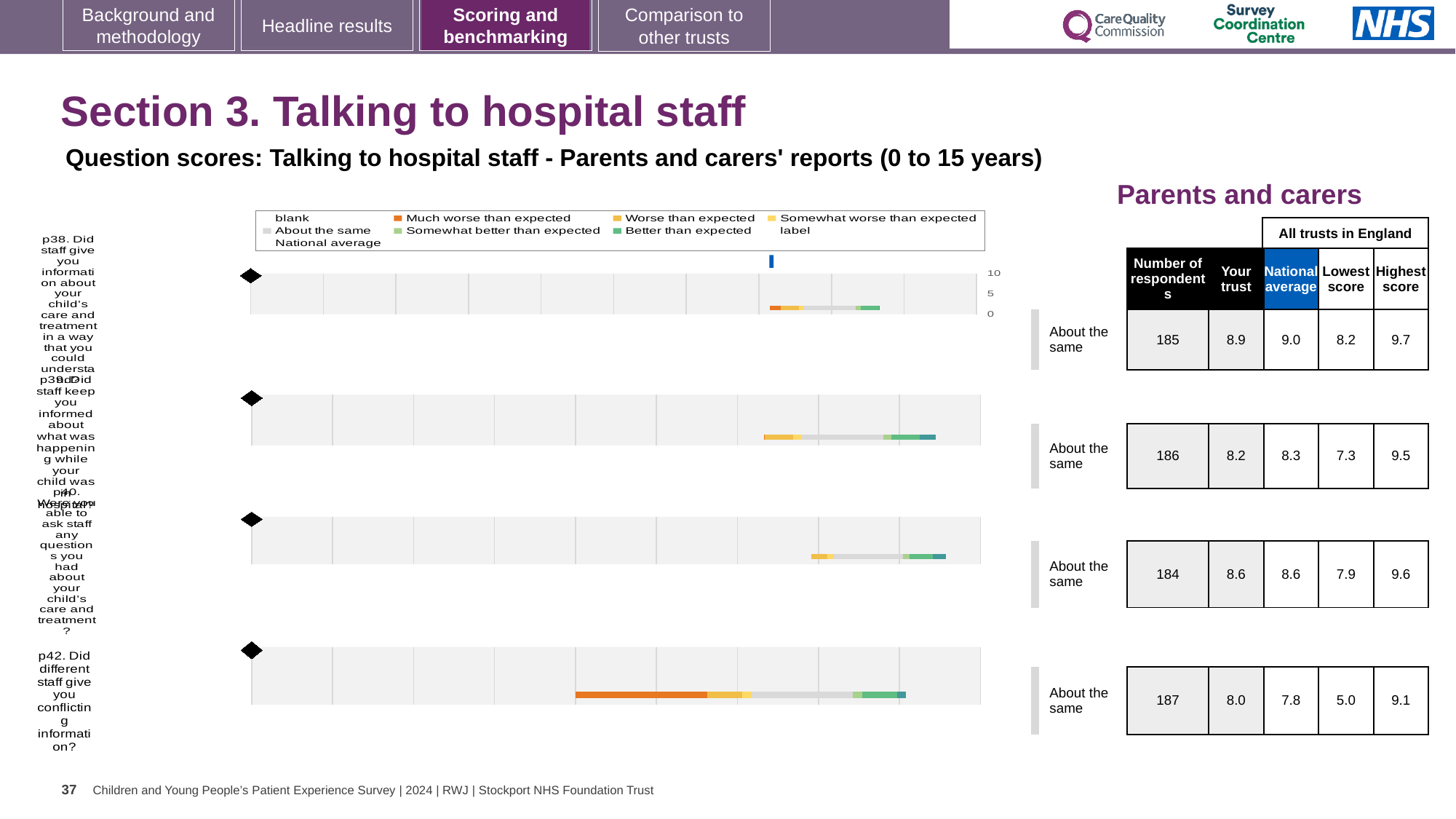
For the p38 chart (staff giving information about your child's care and treatment), what is the 'Your trust' score shown in the table? 8.9 What kind of chart is used to show the question scores on this slide? bar chart How many entries does the legend above the charts list? 9 For the p39 chart (staff keeping you informed about what was happening), how many respondents are shown in the table? 186 Which question chart has the highest 'Your trust' score in the table? p38 In the legend, what colour represents 'Much worse than expected'? orange Which question chart has the lowest 'Lowest score' value in the table? p42 For the p42 chart, which is larger: the 'Your trust' score or the National average? Your trust How many question-score charts are shown on the slide? 4 In the legend, what colour represents 'Better than expected'? green For the p38 chart, what is the difference between the Highest score and the Lowest score in the table? 1.5 For the p42 chart (different staff giving conflicting information), what is the National average score shown in the table? 7.8